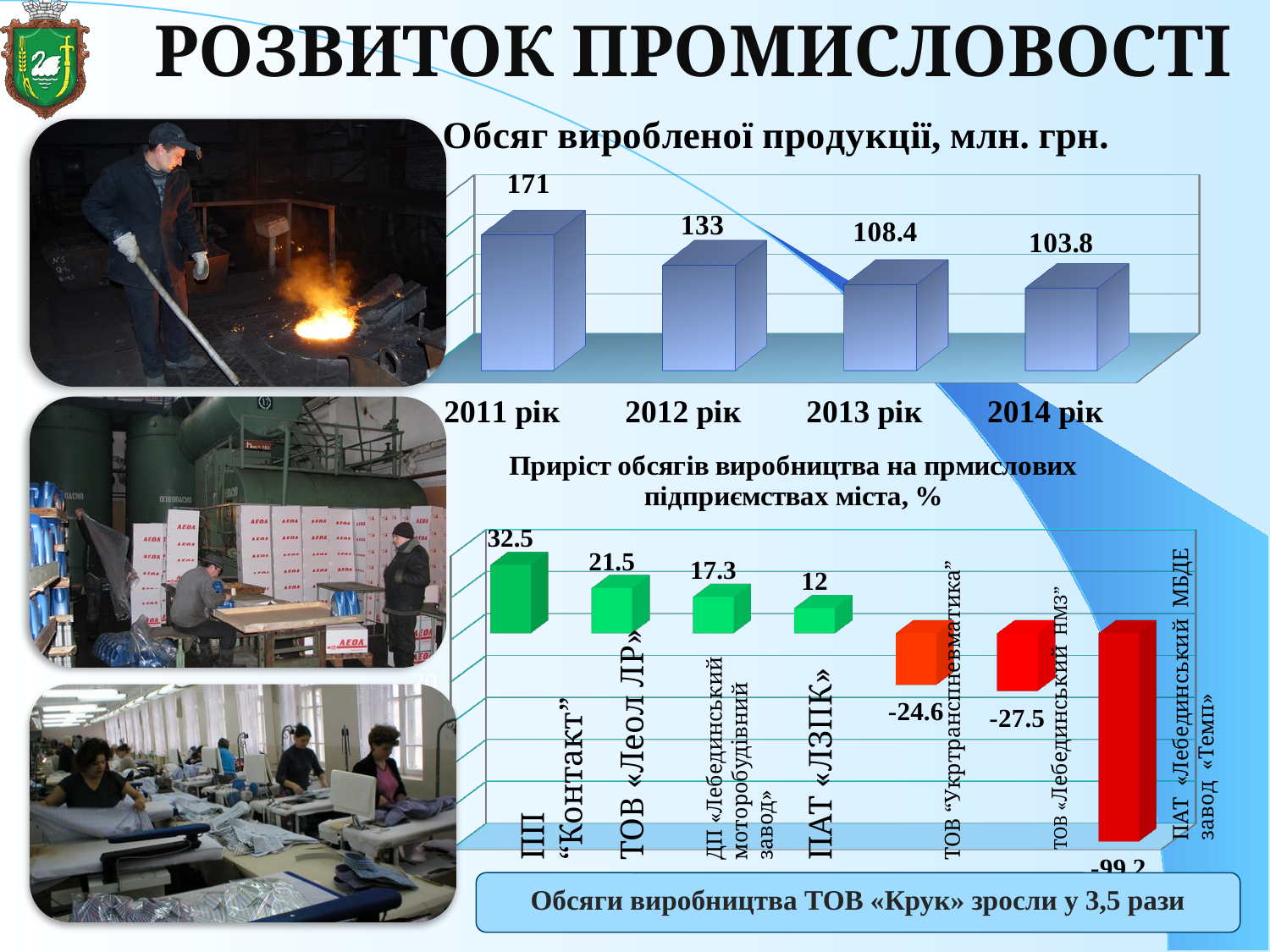
In the chart 'Обсяг виробленої продукції, млн. грн.', what is the difference between the 2011 and 2012 values? 38 In the chart 'Приріст обсягів виробництва на прмислових підприємствах міста, %', which enterprise has the highest value? ПП «Контакт» In the chart 'Обсяг виробленої продукції, млн. грн.', which year has the lowest value? 2014 рік In the chart 'Приріст обсягів виробництва на прмислових підприємствах міста, %', which is larger: the value for ТОВ «Леол ЛР» or the value for ПАТ «ЛЗПК»? ТОВ «Леол ЛР» How many years are shown in the chart 'Обсяг виробленої продукції, млн. грн.'? 4 What type of chart is 'Обсяг виробленої продукції, млн. грн.'? bar chart In the chart 'Обсяг виробленої продукції, млн. грн.', what is the value for 2011 рік? 171 In the chart 'Обсяг виробленої продукції, млн. грн.', do the values rise or fall from 2011 to 2014? fall In the chart 'Приріст обсягів виробництва на прмислових підприємствах міста, %', what is the value for ПП «Контакт»? 32.5 In the chart 'Обсяг виробленої продукції, млн. грн.', what is the value for 2013 рік? 108.4 In the chart 'Приріст обсягів виробництва на прмислових підприємствах міста, %', what is the value for ТОВ «Укртранспневматика»? -24.6 How many enterprises are shown in the chart 'Приріст обсягів виробництва на прмислових підприємствах міста, %'? 7